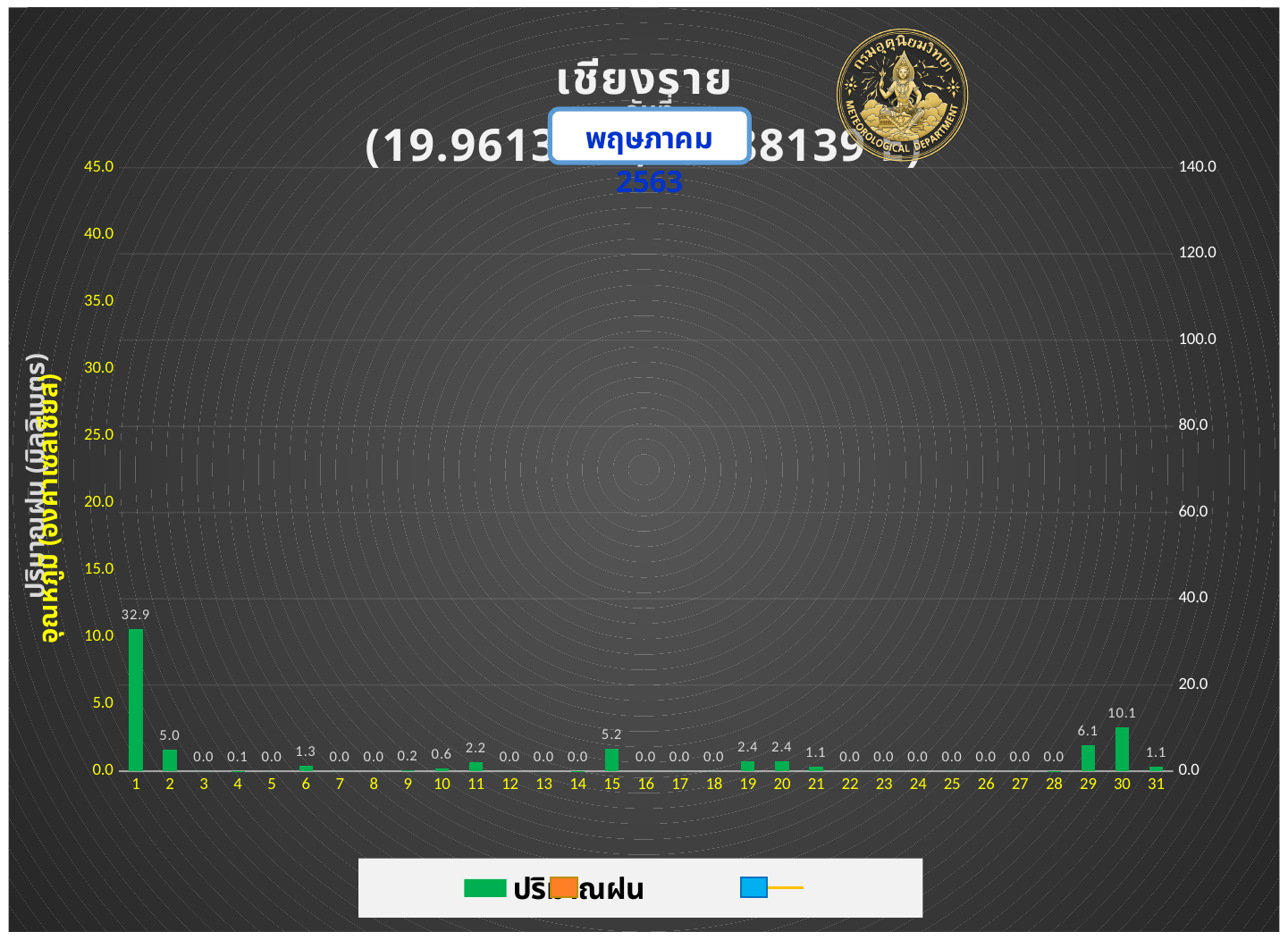
Which day has the highest rainfall value? 1 How many days are shown on the x axis? 31 What is the rainfall value shown for day 29? 6.1 What is the difference between the rainfall values for day 29 and day 2? 1.1 Which is larger, the rainfall value for day 11 or for day 19? day 19 What kind of chart is used to show the rainfall values? bar chart What colour are the rainfall bars? green What is the rainfall value shown for day 1? 32.9 Which is larger, the rainfall value for day 2 or for day 15? day 15 What is the rainfall value shown for day 30? 10.1 What is the difference between the rainfall values for day 1 and day 30? 22.8 What is the rainfall value shown for day 15? 5.2